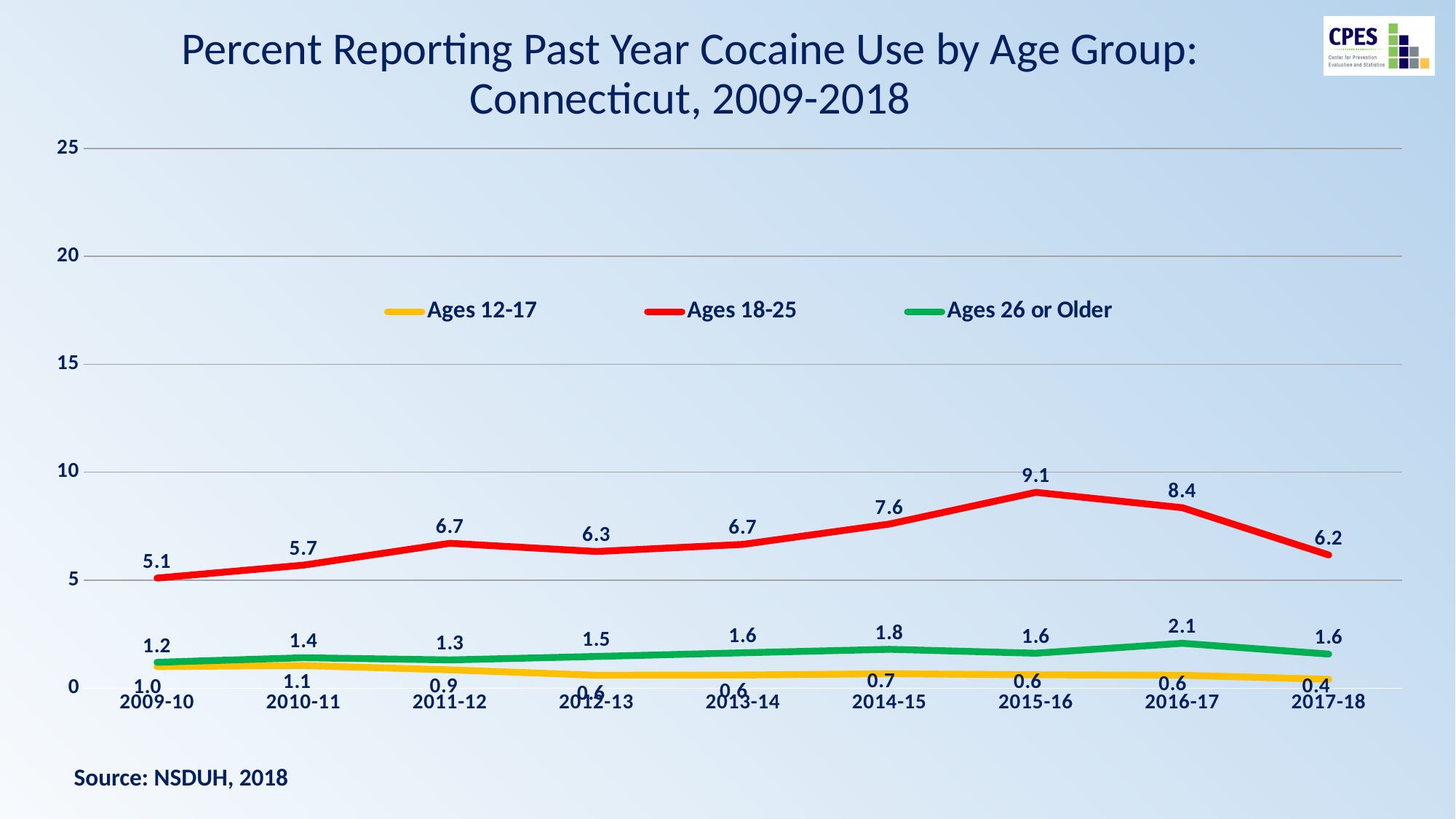
What is the difference between the Ages 18-25 values in 2015-16 and 2017-18? 2.9 What colour is the line for Ages 18-25? red In which period is the value for Ages 18-25 highest? 2015-16 How many series does the legend list? 3 What is the value for Ages 18-25 in 2015-16? 9.1 Which is larger in 2014-15: the value for Ages 26 or Older or the value for Ages 12-17? Ages 26 or Older What kind of chart is shown on the slide? line chart In which period is the value for Ages 12-17 lowest? 2017-18 Is the value for Ages 18-25 in 2016-17 greater or less than 10? less What is the value for Ages 26 or Older in 2016-17? 2.1 What is the value for Ages 12-17 in 2009-10? 1.0 How many time periods are shown on the x axis? 9